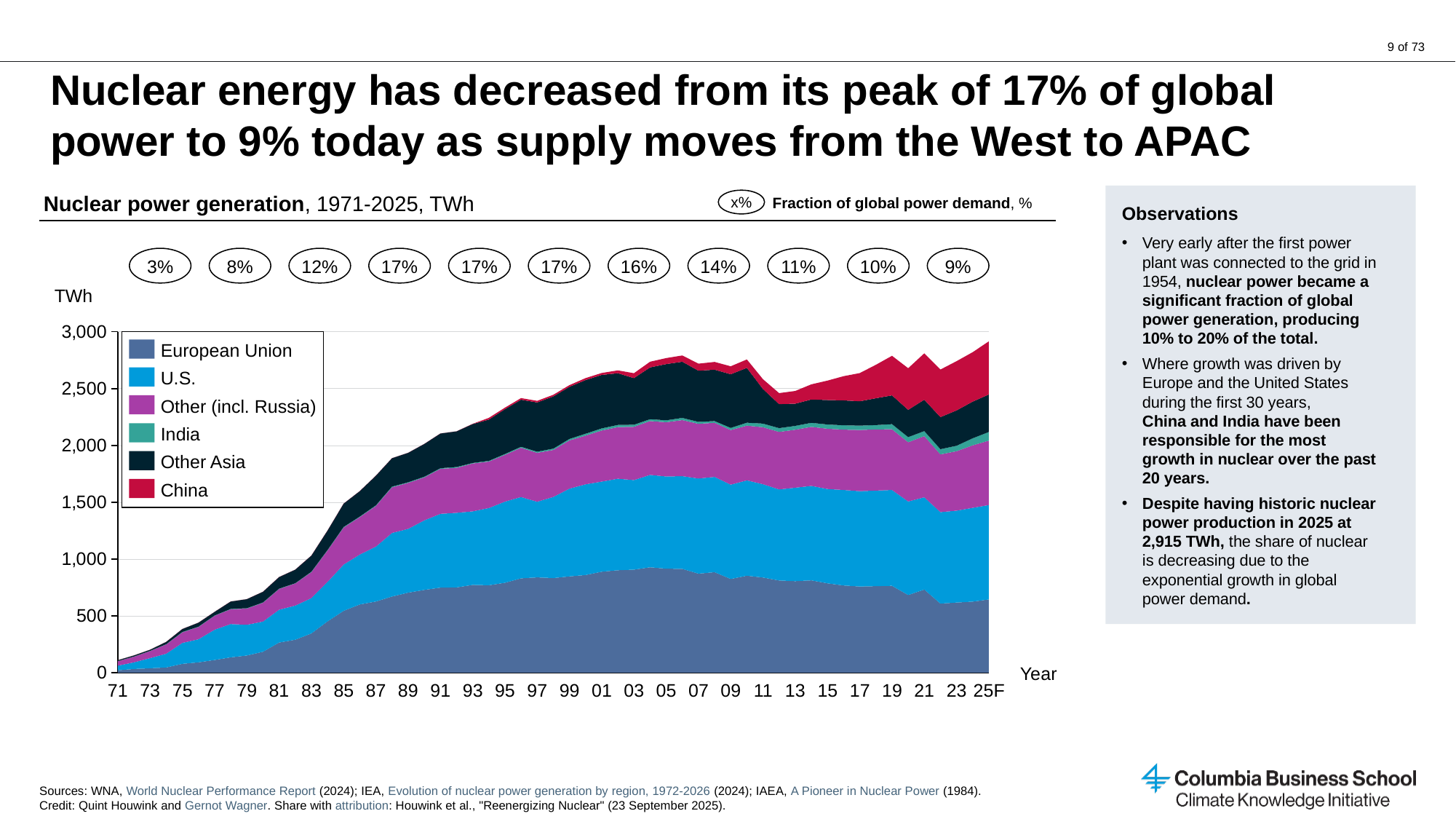
What is the lowest fraction of global power demand shown in the ovals above the chart? 3% What is the highest fraction of global power demand shown in the ovals above the chart? 17% What is the difference between the peak fraction of global power demand (17%) and the final fraction (9%) shown above the chart? 8 percentage points What fraction of global power demand is shown in the last (rightmost) oval above the chart? 9% What is the unit of the y axis of the chart? TWh Which series is plotted at the bottom of the stacked area chart? European Union How many series does the chart legend list? 6 Is the total nuclear power generation in 25F greater or less than 2,500 TWh? greater Does total nuclear power generation rise or fall between 1971 and 2005? rise What kind of chart is shown on the slide? Stacked area chart Is the total nuclear power generation in 1981 greater or less than 1,000 TWh? less How many fraction-of-global-power-demand ovals are shown above the chart? 11